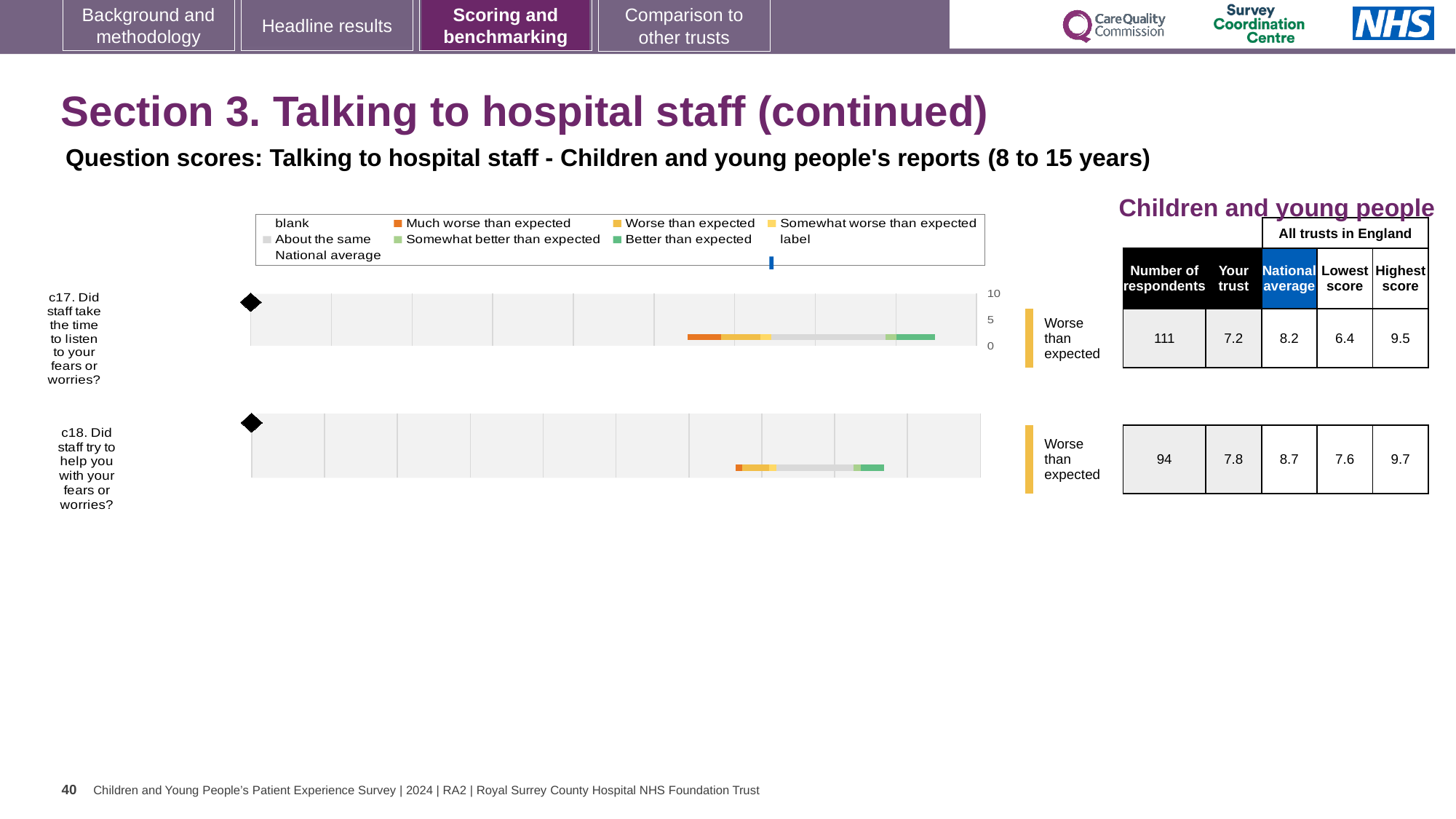
Which question had more respondents, c17 or c18? c17 How many survey questions are plotted on this slide? 2 What kind of chart is used to show the benchmarking results on this slide? Bar chart For question c17, how much higher is the national average than the 'Your trust' score? 1.0 What is the highest score among all trusts in England for question c18? 9.7 What is the 'Your trust' score for question c17 (Did staff take the time to listen to your fears or worries?)? 7.2 How many respondents answered question c18 (Did staff try to help you with your fears or worries?)? 94 What benchmark category is shown for question c17? Worse than expected What is the lowest score among all trusts in England for question c17? 6.4 For question c18, what is the difference between the highest score and the lowest score among all trusts in England? 2.1 What is the national average score for question c17? 8.2 Which question has the higher 'Your trust' score, c17 or c18? c18